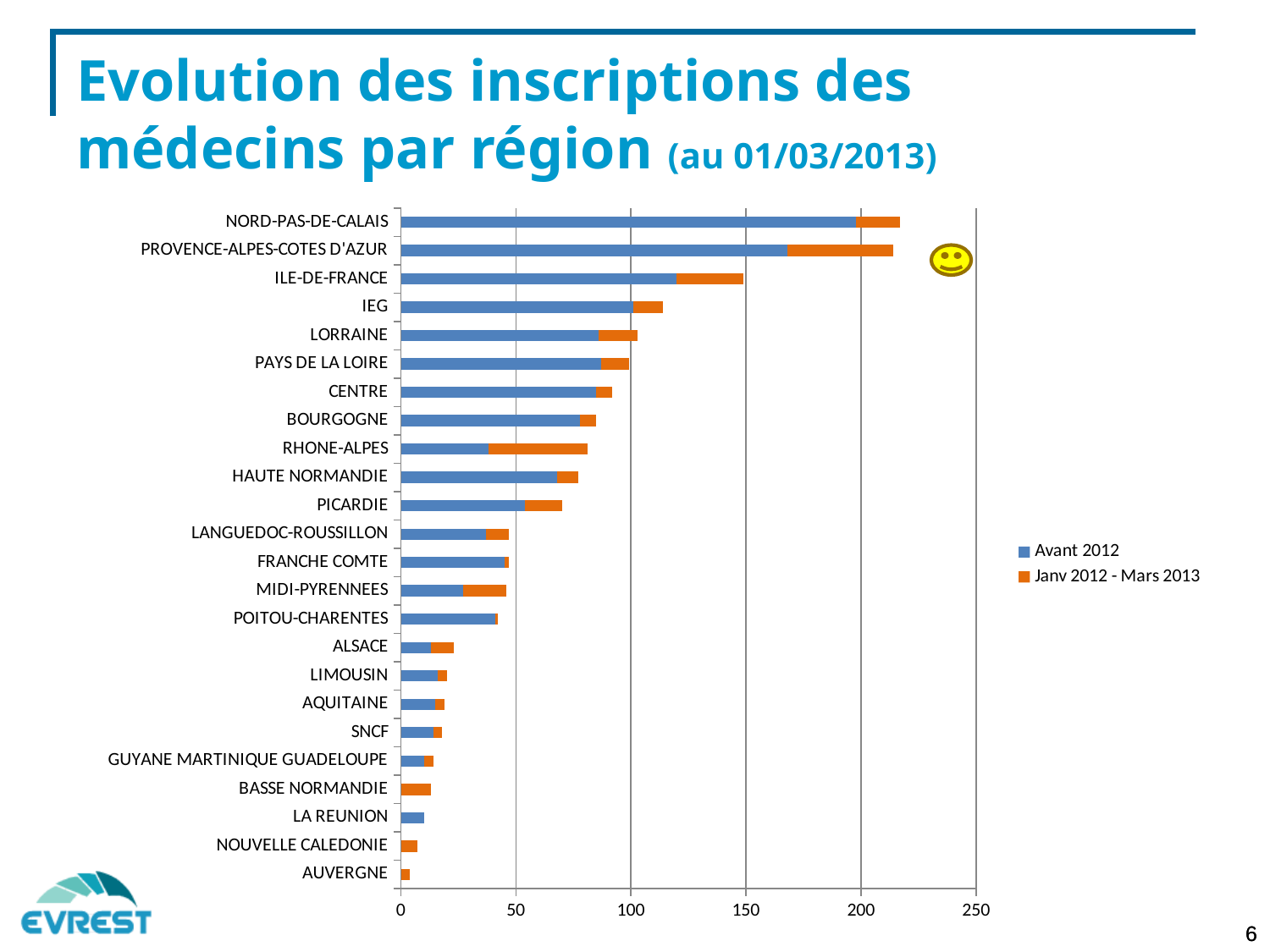
How many regions (categories) are plotted on the chart? 24 Is the total bar for POITOU-CHARENTES greater or less than 50? less What are the two series named in the legend? Avant 2012; Janv 2012 - Mars 2013 What kind of chart is shown on the slide? bar chart Which has the longer total bar, ILE-DE-FRANCE or IEG? ILE-DE-FRANCE Which region has the shortest total bar? AUVERGNE Is the 'Avant 2012' value for RHONE-ALPES greater or less than 50? less Is the 'Avant 2012' value for PROVENCE-ALPES-COTES D'AZUR greater or less than 150? greater Which region has the larger 'Avant 2012' segment, BOURGOGNE or RHONE-ALPES? BOURGOGNE Which region has the largest 'Avant 2012' segment? NORD-PAS-DE-CALAIS How many series does the legend list? 2